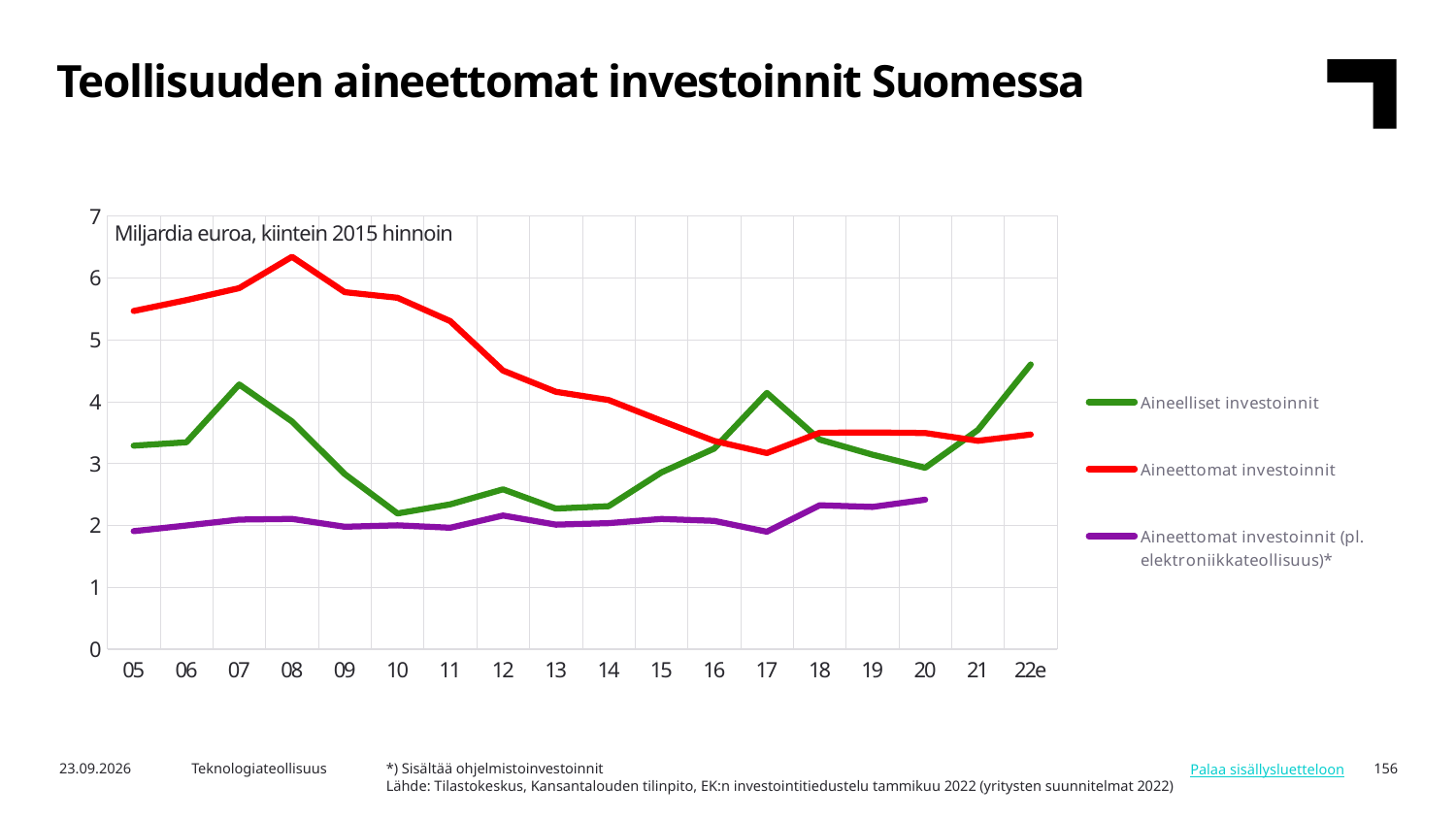
In 05, which is larger: Aineelliset investoinnit or Aineettomat investoinnit? Aineettomat investoinnit Does the Aineelliset investoinnit series rise or fall from 20 to 22e? rise Is the value for Aineettomat investoinnit in 05 greater or less than 5? greater How many series does the legend list? 3 What unit label is shown inside the chart area? Miljardia euroa, kiintein 2015 hinnoin What type of chart is shown on the slide? line chart In 17, which is larger: Aineelliset investoinnit or Aineettomat investoinnit? Aineelliset investoinnit Is the value for Aineelliset investoinnit in 10 greater or less than 3? less Does the Aineettomat investoinnit series rise or fall from 08 to 17? fall How many years are shown on the x axis? 18 In which year does the Aineettomat investoinnit series reach its highest value? 08 Is the value for Aineelliset investoinnit in 22e greater or less than 4? greater